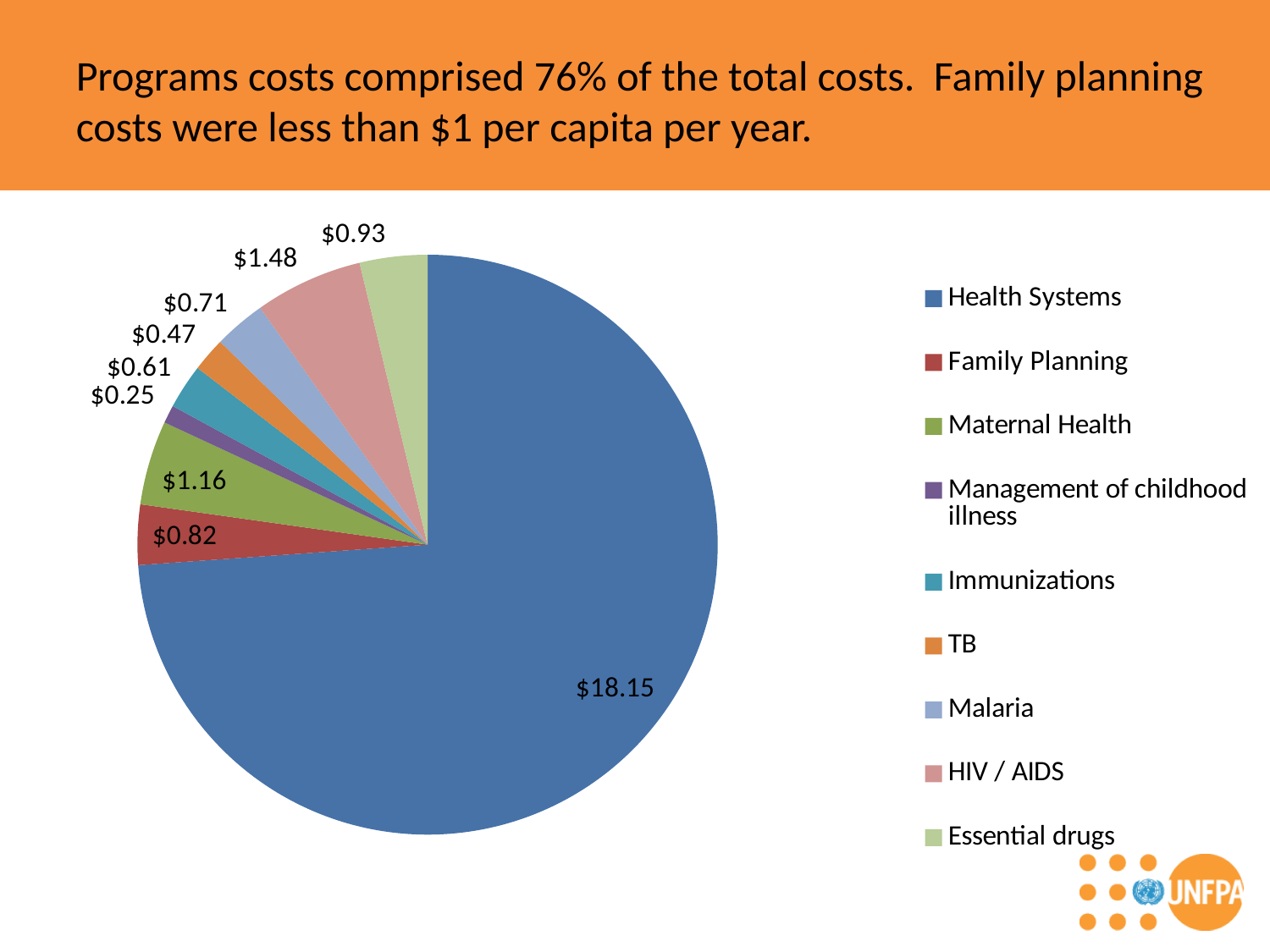
What is the value shown for HIV / AIDS in the pie chart? $1.48 What is the value shown for Essential drugs in the pie chart? $0.93 Which category has the smallest slice in the pie chart? Management of childhood illness What is the value shown for Health Systems in the pie chart? $18.15 What type of chart is shown on the slide? Pie chart Which category has the largest slice in the pie chart? Health Systems What is the difference between the HIV / AIDS value and the Essential drugs value? $0.55 How many categories does the legend of the pie chart list? 9 What is the value shown for Management of childhood illness in the pie chart? $0.25 What is the difference between the Health Systems value and the Family Planning value? $17.33 What is the value shown for Family Planning in the pie chart? $0.82 Which is larger, the value for Maternal Health or the value for Malaria? Maternal Health